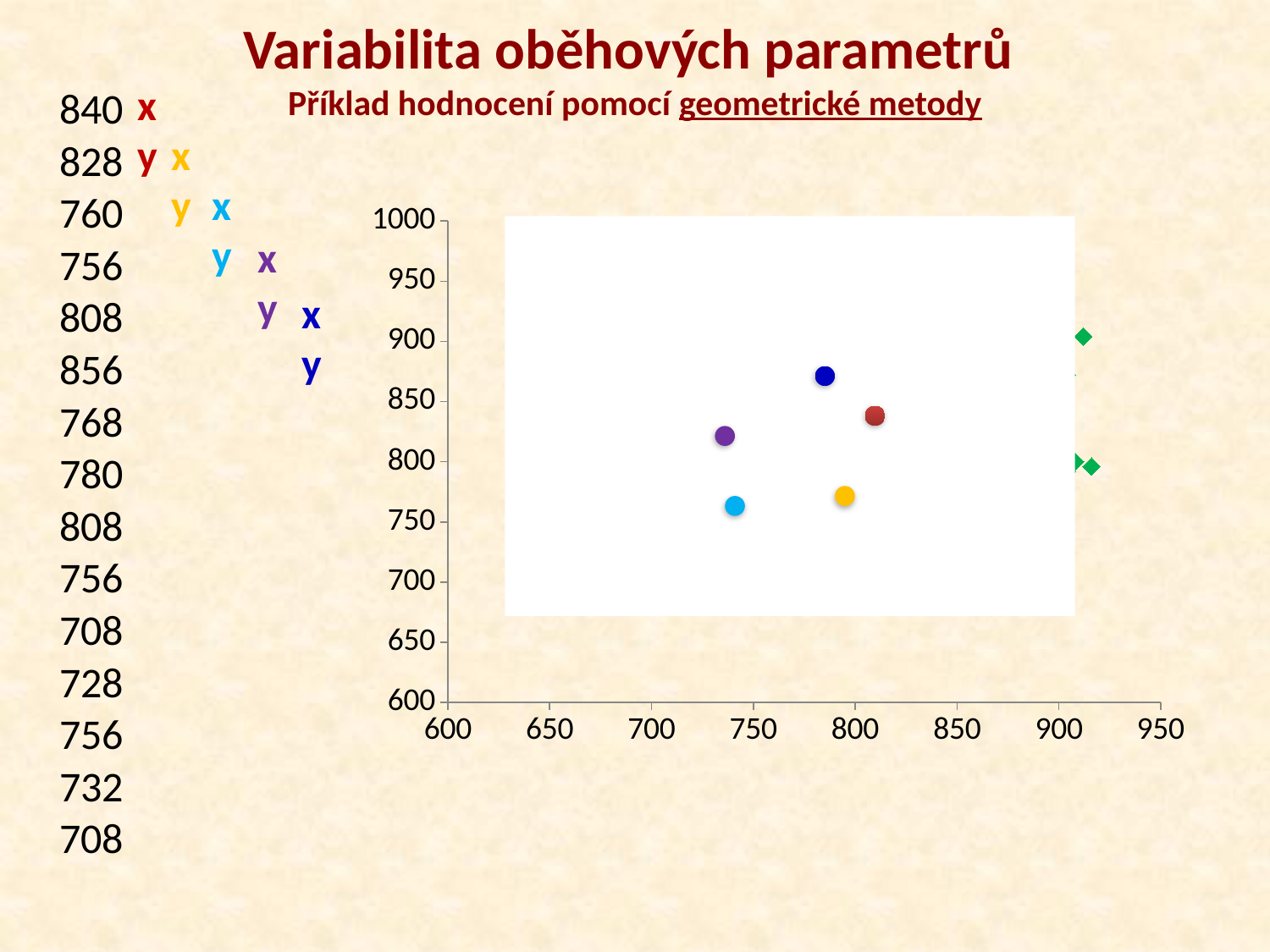
Is the vertical (y) value of the yellow point greater or less than 800? less Is the horizontal (x) value of the red point greater or less than 800? greater Which has the larger horizontal (x) value, the red point or the light blue point? the red point What is the lowest value shown on the horizontal axis? 600 Which has the higher vertical (y) value, the dark blue point or the yellow point? the dark blue point How many large circular markers are plotted on the chart? 5 What kind of chart is shown on the slide? scatter chart What is the highest value shown on the vertical axis? 1000 Is the vertical (y) value of the purple point greater or less than 800? greater Which circular point has the highest vertical (y) value? the dark blue point